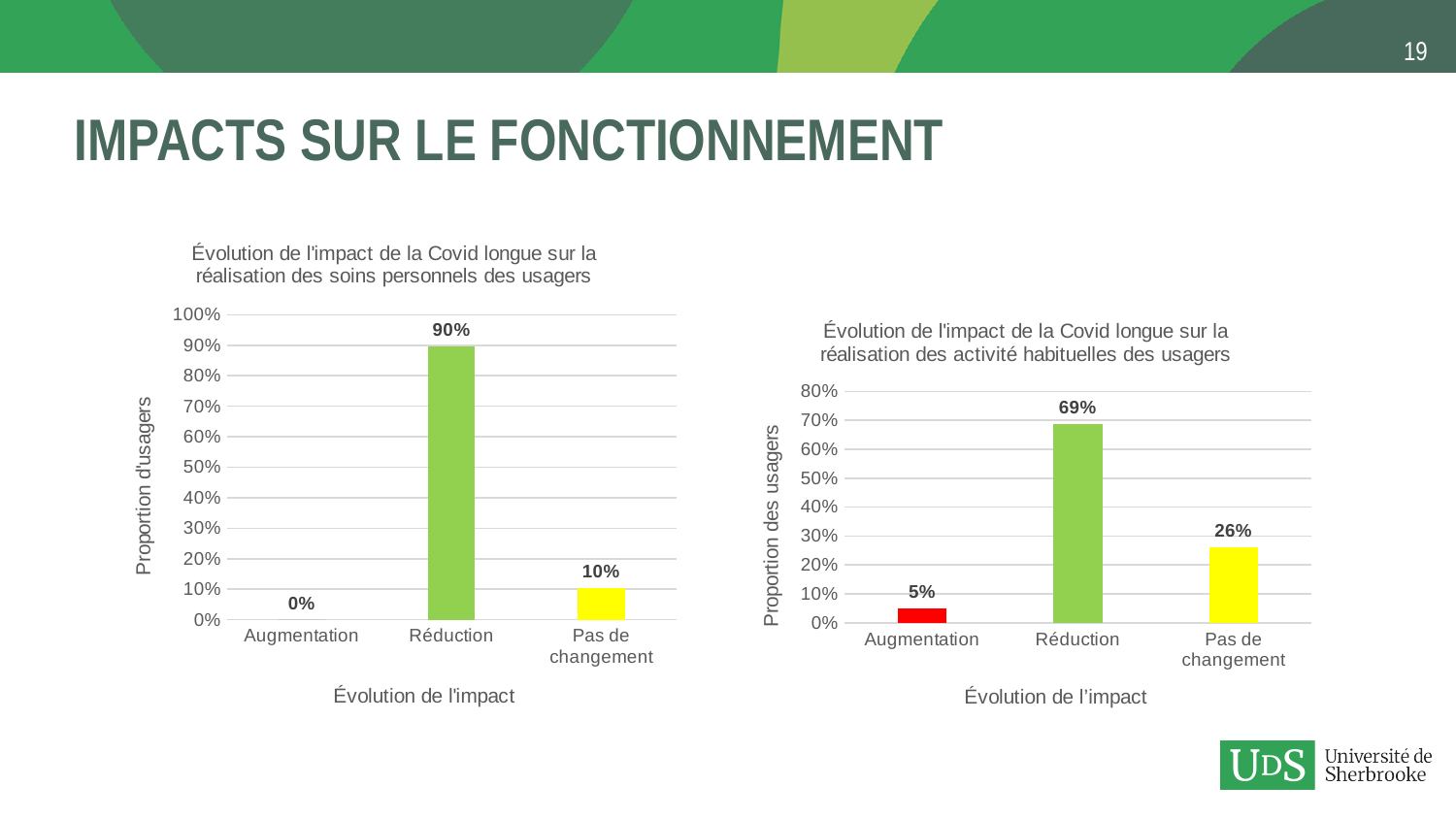
What type of chart is the left chart (soins personnels)? Bar chart In the right chart (activité habituelles), what is the difference between Réduction and Pas de changement? 43% In the left chart (soins personnels), what is the value for Augmentation? 0% How many categories are shown on the x axis of the right chart (activité habituelles)? 3 In the right chart (activité habituelles), which category has the highest value? Réduction In the right chart (activité habituelles), what is the value for Réduction? 69% In the right chart (activité habituelles), what is the value for Augmentation? 5% In the right chart (activité habituelles), which is larger: Pas de changement or Augmentation? Pas de changement In the left chart (soins personnels), what is the value for Pas de changement? 10% In the left chart (soins personnels), what is the value for Réduction? 90% In the left chart (soins personnels), which category has the lowest value? Augmentation In the left chart (soins personnels), what is the difference between Réduction and Pas de changement? 80%